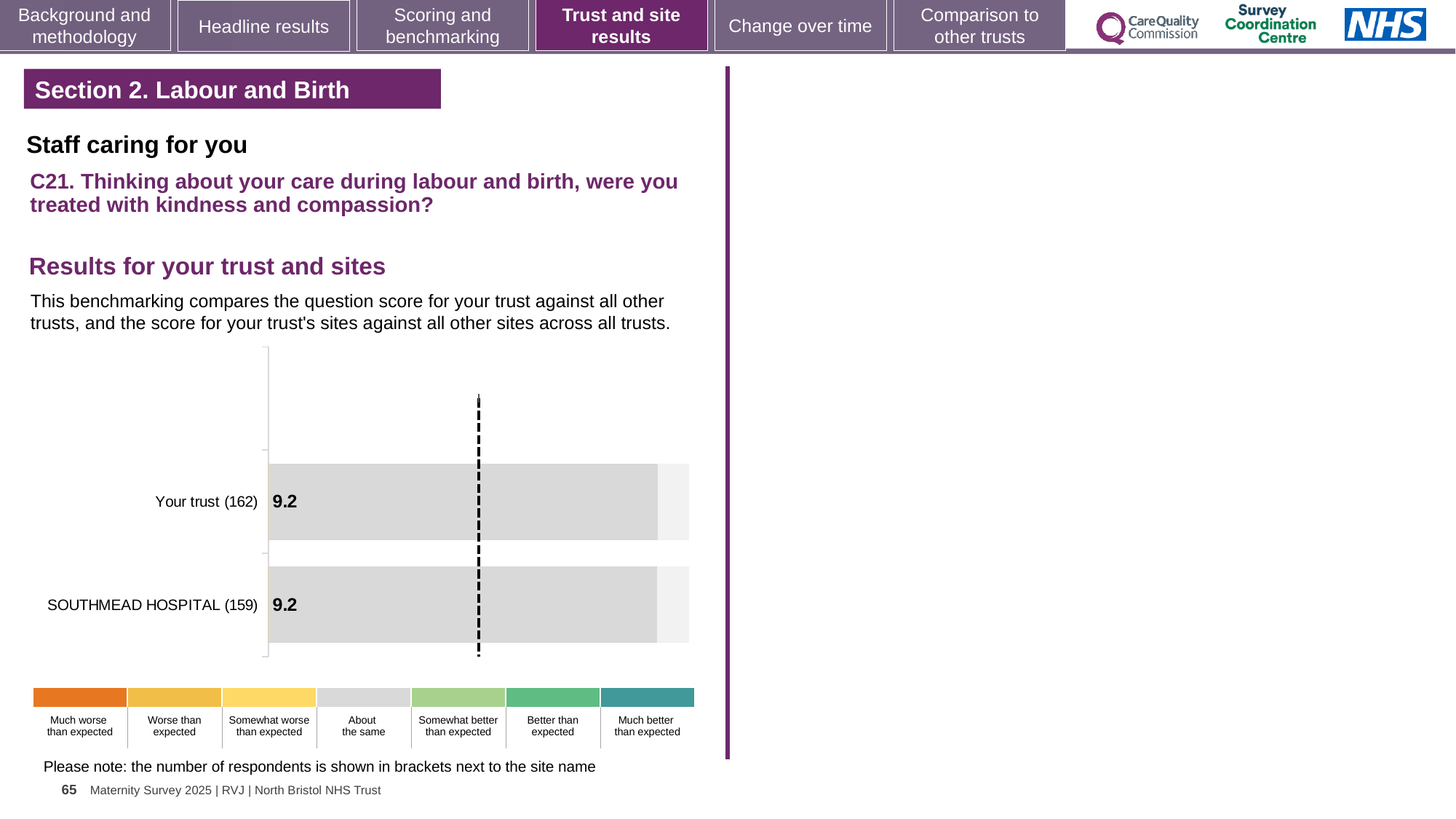
How many categories does the colour key below the chart list? 7 How many respondents are shown in brackets for Your trust? 162 Is the score for SOUTHMEAD HOSPITAL (159) greater or less than 10? less How many respondents are shown in brackets for SOUTHMEAD HOSPITAL? 159 Is the score for Your trust (162) greater or less than 5? greater According to the colour key, what does a grey bar indicate? About the same What is the difference between the score for Your trust (162) and the score for SOUTHMEAD HOSPITAL (159)? 0 What is the score for Your trust (162)? 9.2 What kind of chart is shown on the slide? Bar chart What is the score for SOUTHMEAD HOSPITAL (159)? 9.2 How many bars are plotted in the chart? 2